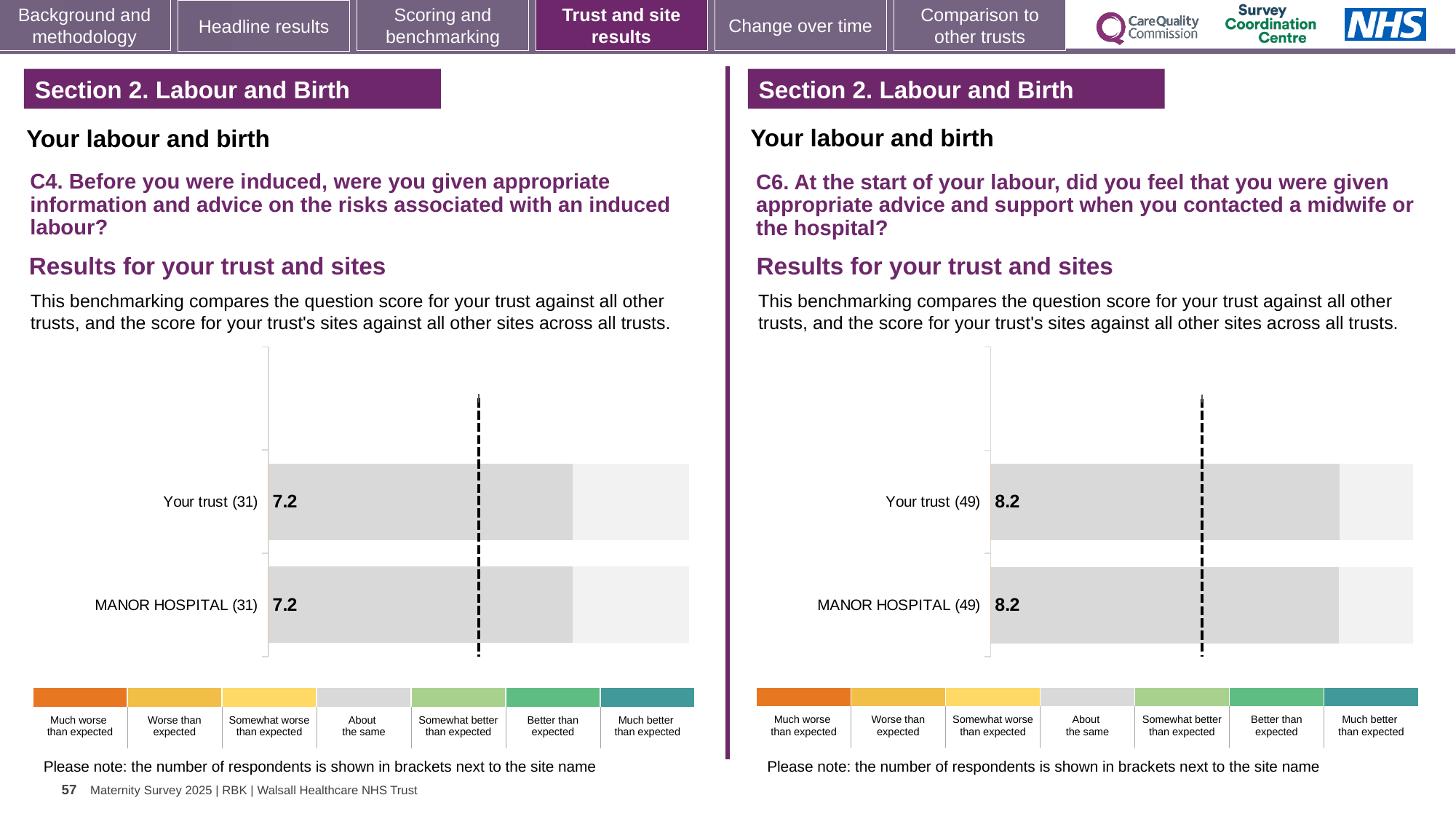
Is the score for Your trust on the right chart (C6) larger or smaller than the score for Your trust on the left chart (C4)? Larger How many bars are plotted on the left chart (C4)? 2 What kind of chart is used on the left (C4)? Bar chart On the left chart (C4), how many respondents are shown in brackets next to Your trust? 31 How many bars are plotted on the right chart (C6)? 2 On the right chart (C6), how many respondents are shown in brackets next to MANOR HOSPITAL? 49 On the right chart (C6), what is the score for MANOR HOSPITAL? 8.2 On the left chart (C4), what is the difference between the scores for Your trust and MANOR HOSPITAL? 0 On the left chart (C4), what is the score for Your trust? 7.2 On the left chart (C4), what is the score for MANOR HOSPITAL? 7.2 On the right chart (C6), what is the score for Your trust? 8.2 On the right chart (C6), what is the difference between the scores for Your trust and MANOR HOSPITAL? 0